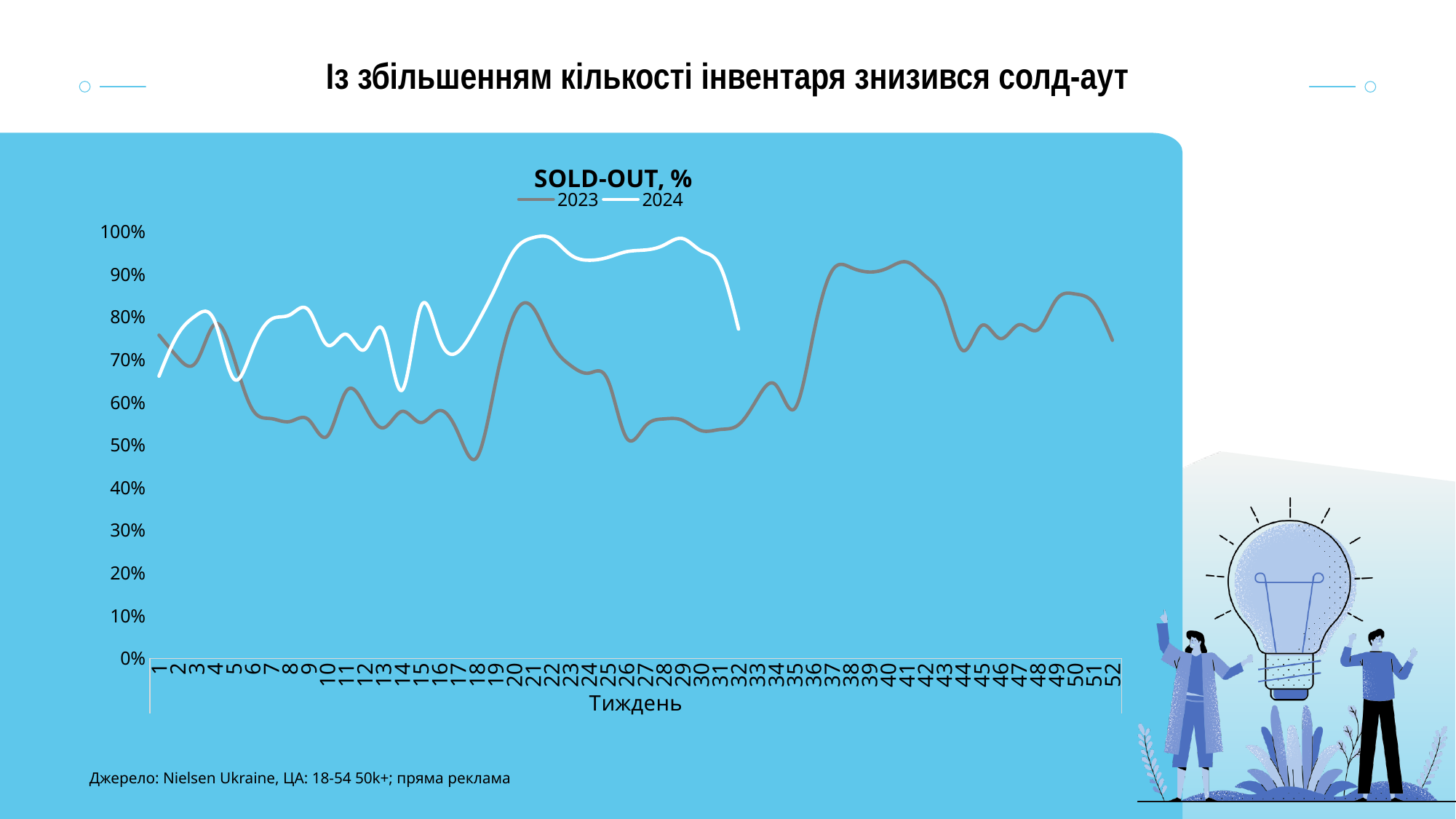
Does the 2024 series rise or fall between week 29 and week 32? fall At week 21, which series has the higher value, 2023 or 2024? 2024 Is the 2024 value at week 14 greater or less than 70%? less Is the 2023 value at week 18 greater or less than 50%? less In which week does the 2023 series reach its lowest value? 18 What are the two series named in the legend? 2023 and 2024 Is the 2024 value at week 21 greater or less than 90%? greater How many series does the legend of the SOLD-OUT, % chart list? 2 What is the label of the x axis? Тиждень How many weeks are marked along the x axis? 52 What kind of chart is shown on the slide? line chart